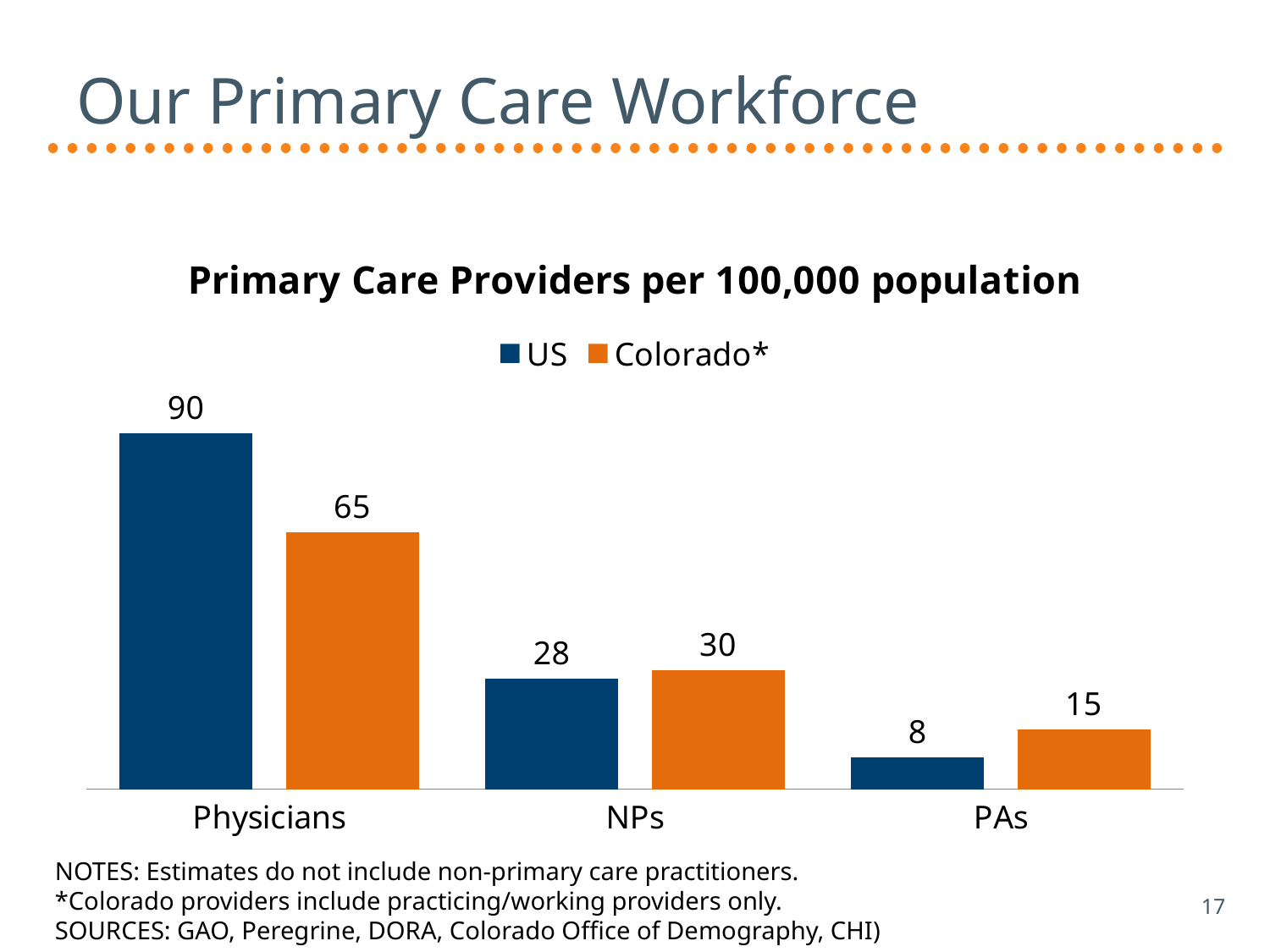
What is the Colorado* value for Physicians? 65 How many categories are shown on the x axis? 3 Which is larger for NPs, the US value or the Colorado* value? Colorado* Which category has the highest US value? Physicians What is the difference between the US and Colorado* values for Physicians? 25 How many series does the legend list? 2 Which category has the lowest Colorado* value? PAs What is the difference between the Colorado* and US values for PAs? 7 What is the US value for Physicians? 90 What is the US value for PAs? 8 What is the Colorado* value for NPs? 30 What kind of chart is shown on the slide? Bar chart